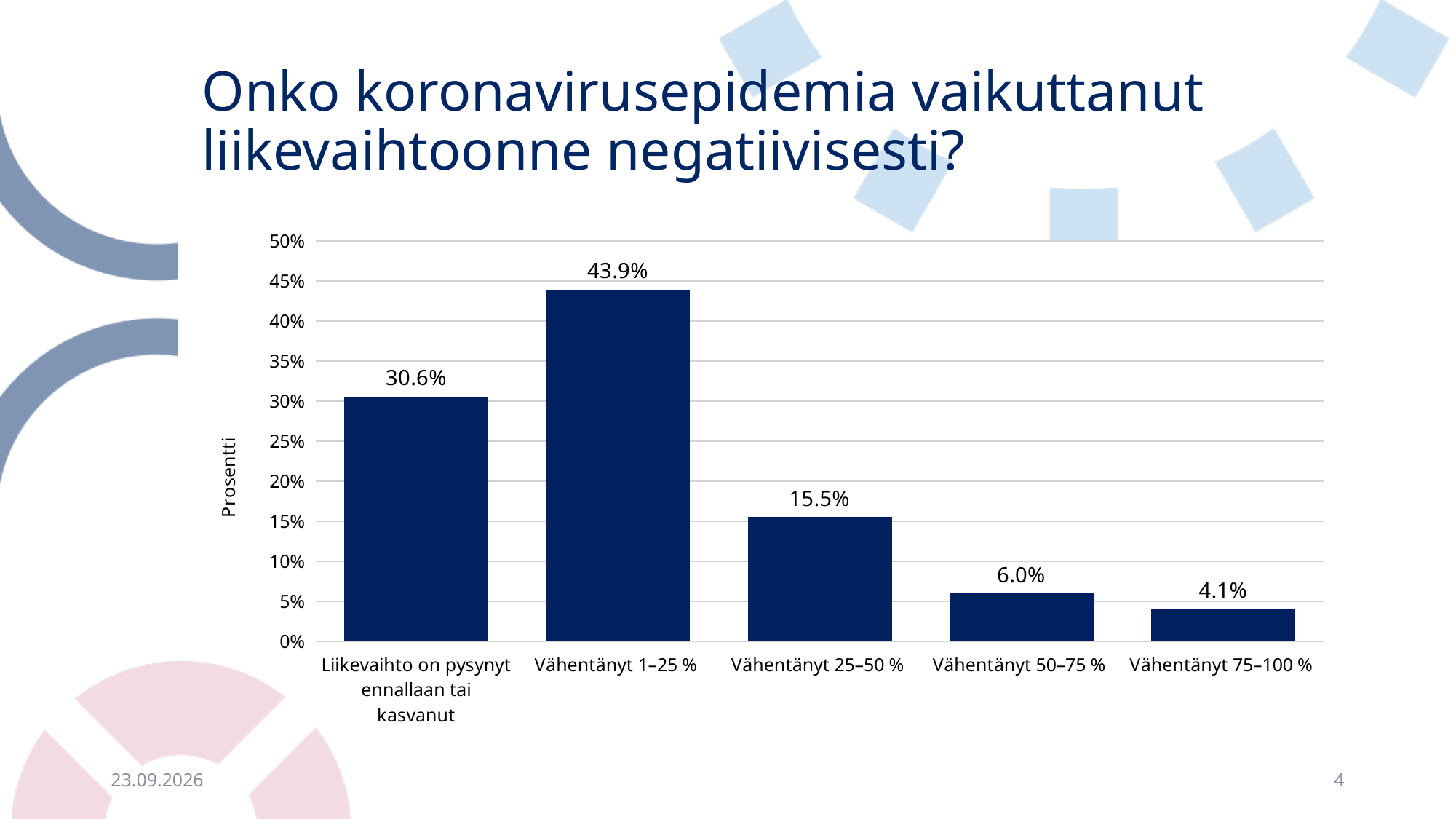
What is the label of the vertical axis? Prosentti What is the value for "Liikevaihto on pysynyt ennallaan tai kasvanut"? 30.6% What is the value for "Vähentänyt 1–25 %"? 43.9% How many categories are shown in the chart? 5 What is the difference between the values for "Vähentänyt 50–75 %" and "Vähentänyt 75–100 %"? 1.9% Which is larger: the value for "Vähentänyt 50–75 %" or "Vähentänyt 75–100 %"? Vähentänyt 50–75 % Which category has the highest value? Vähentänyt 1–25 % What is the difference between the values for "Vähentänyt 1–25 %" and "Vähentänyt 25–50 %"? 28.4% What is the value for "Vähentänyt 75–100 %"? 4.1% Is the value for "Vähentänyt 25–50 %" greater or less than 20%? less What kind of chart is shown on the slide? bar chart Which category has the lowest value? Vähentänyt 75–100 %